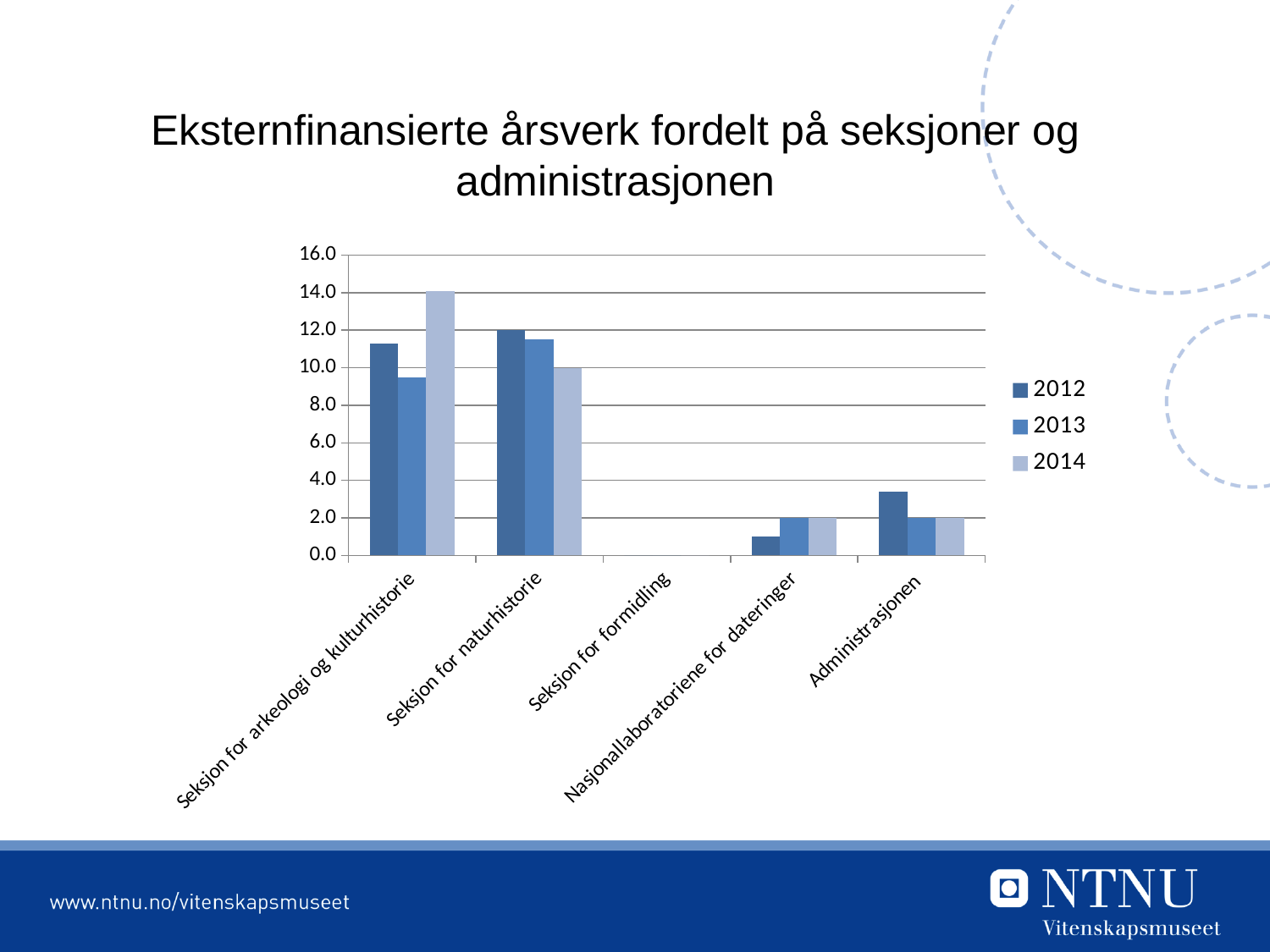
Which category has the highest value for 2014? Seksjon for arkeologi og kulturhistorie Which category has the lowest value for 2012? Seksjon for formidling What is the value for Administrasjonen in 2013? 2.0 Is the 2013 value for Seksjon for arkeologi og kulturhistorie greater or less than 10.0? less How many categories are shown on the x axis? 5 How many series does the legend list? 3 What kind of chart is shown on the slide? bar chart Is the 2014 value for Seksjon for arkeologi og kulturhistorie greater or less than 12.0? greater Is the 2012 value for Administrasjonen greater or less than 4.0? less Do the values for Seksjon for naturhistorie rise or fall from 2012 to 2014? fall What is the value for Seksjon for naturhistorie in 2014? 10.0 Which is larger in 2014: Seksjon for arkeologi og kulturhistorie or Seksjon for naturhistorie? Seksjon for arkeologi og kulturhistorie